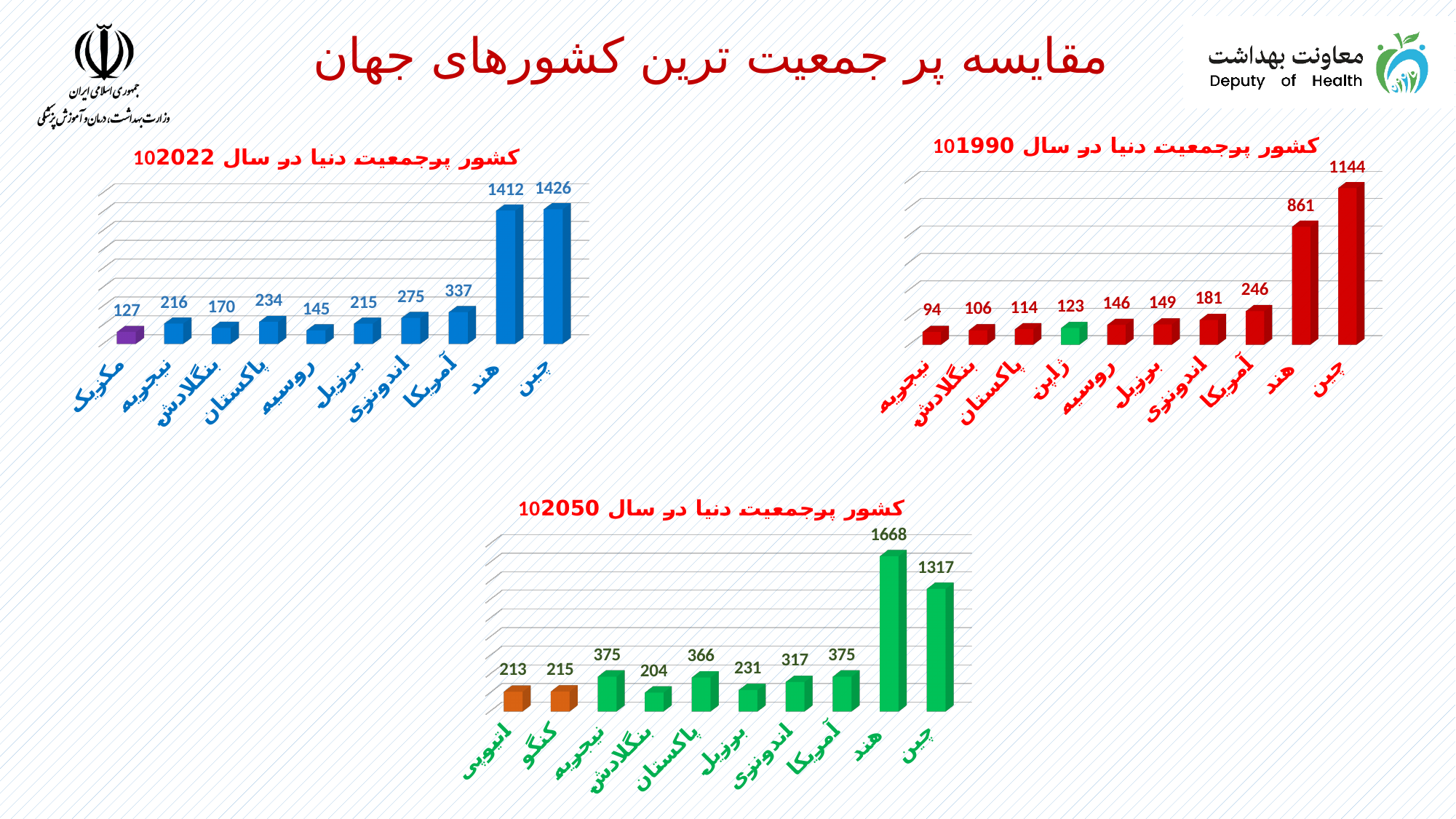
What kind of chart is the 2050 chart (bottom)? bar chart In the 1990 chart (top right), how many countries are shown? 10 In the 1990 chart (top right), which country has the highest value? چین (China) In the 1990 chart (top right), what is the value for هند (India)? 861 In the 2050 chart (bottom), which country has the lowest value? بنگلادش (Bangladesh) In the 2050 chart (bottom), what is the difference between the values for هند (India) and چین (China)? 351 In the 2050 chart (bottom), which bar is drawn in a different colour from the green bars besides اتیوپی (Ethiopia)? کنگو (Congo) In the 2022 chart (top left), what is the difference between the values for چین (China) and هند (India)? 14 In the 2050 chart (bottom), what is the value for هند (India)? 1668 In the 1990 chart (top right), which is larger, the value for آمریکا (USA) or اندونزی (Indonesia)? آمریکا (USA) In the 2022 chart (top left), what is the value for چین (China)? 1426 In the 2022 chart (top left), which country has the lowest value? مکزیک (Mexico)